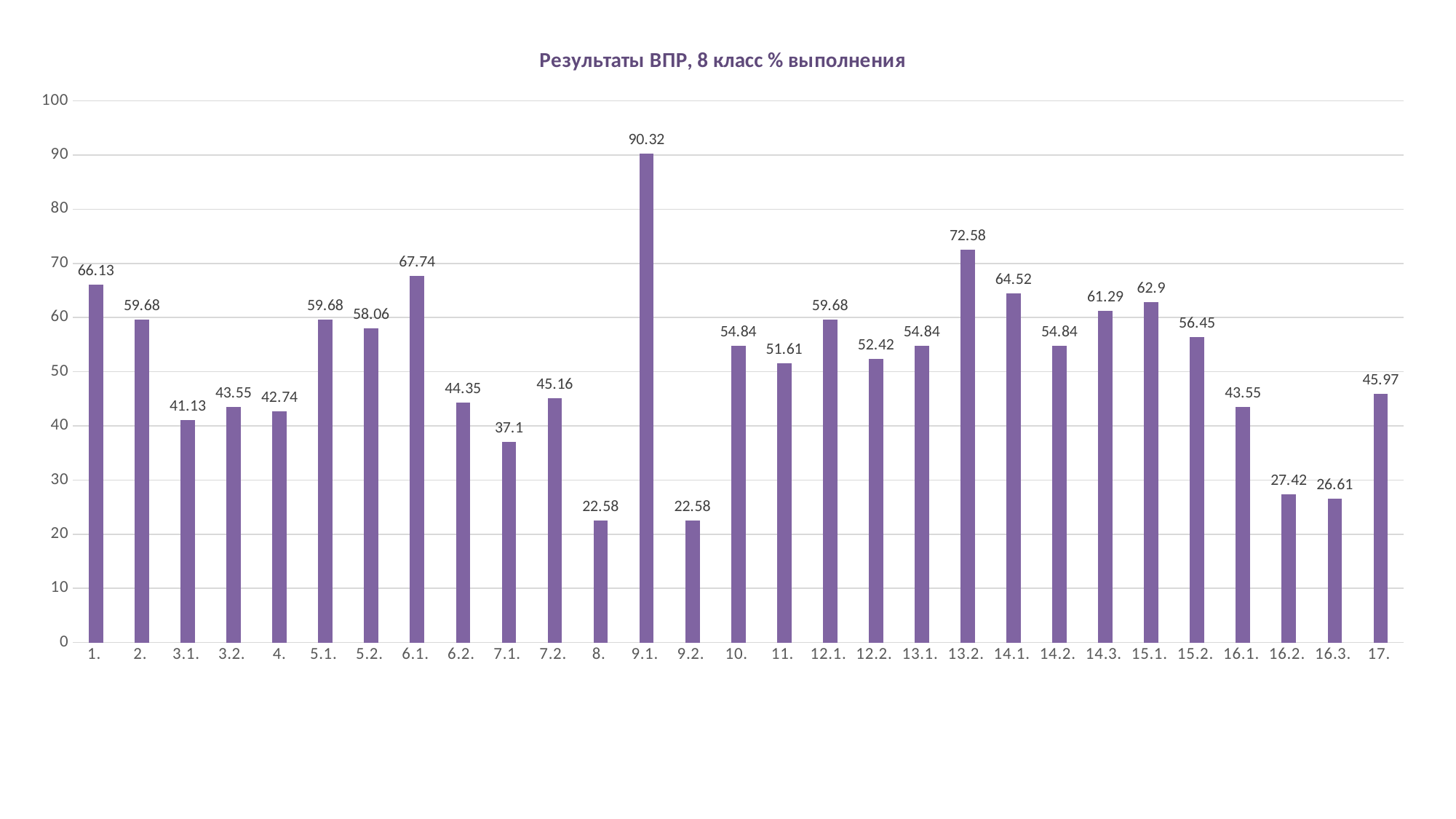
What is the title of the chart? Результаты ВПР, 8 класс % выполнения What is the value for category 16.3.? 26.61 Which category has the highest value? 9.1. What kind of chart is shown on the slide? bar chart Is the value for 7.1. greater or less than 40? less What is the value for category 13.2.? 72.58 What is the difference between the values for 13.2. and 12.2.? 20.16 How many categories are shown on the x axis? 29 What is the lowest value shown on the chart? 22.58 What is the value for category 9.1.? 90.32 Which is larger, the value for 1. or the value for 2.? 1. What is the difference between the values for 6.1. and 6.2.? 23.39